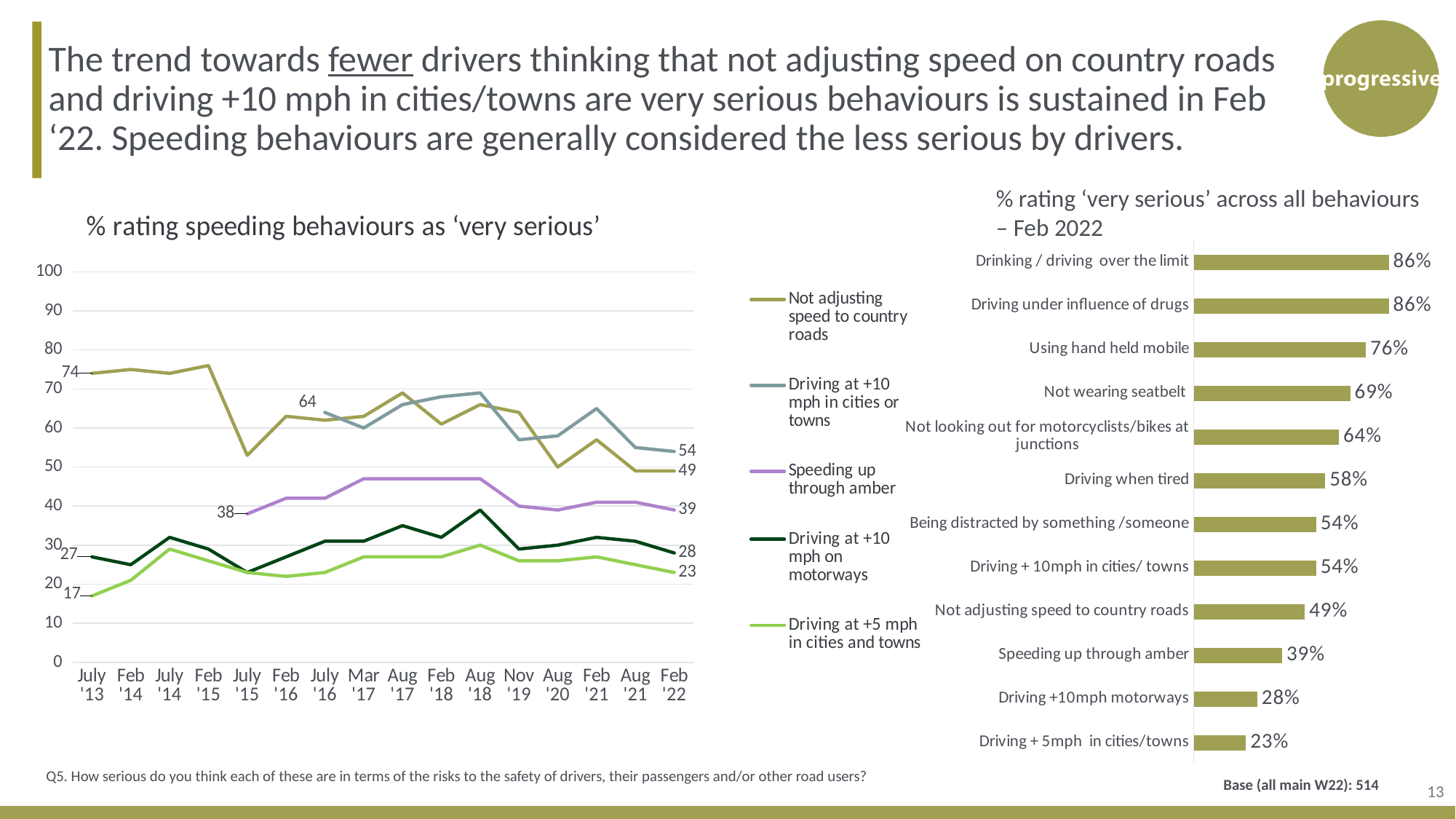
In the '% rating speeding behaviours as very serious' chart, what is the Feb '22 value for 'Speeding up through amber'? 39 In the '% rating speeding behaviours as very serious' chart, what is the Feb '22 value for 'Driving at +10 mph in cities or towns'? 54 In the '% rating very serious across all behaviours – Feb 2022' chart, which behaviour has the lowest value? Driving + 5mph in cities/towns In the '% rating speeding behaviours as very serious' chart, is the Feb '15 value for 'Not adjusting speed to country roads' greater or less than 70? greater In the '% rating speeding behaviours as very serious' chart, what is the July '13 value for 'Not adjusting speed to country roads'? 74 In the '% rating very serious across all behaviours – Feb 2022' chart, how many behaviours are listed? 12 In the '% rating very serious across all behaviours – Feb 2022' chart, what is the value for 'Not wearing seatbelt'? 69% In the '% rating speeding behaviours as very serious' chart, how many series does the legend list? 5 In the '% rating very serious across all behaviours – Feb 2022' chart, what is the difference between 'Using hand held mobile' and 'Driving when tired'? 18% What kind of chart is '% rating speeding behaviours as very serious'? line chart In the '% rating speeding behaviours as very serious' chart, what is the difference between the July '13 and Feb '22 values for 'Not adjusting speed to country roads'? 25 In the '% rating speeding behaviours as very serious' chart, how many time points are shown on the x axis? 16